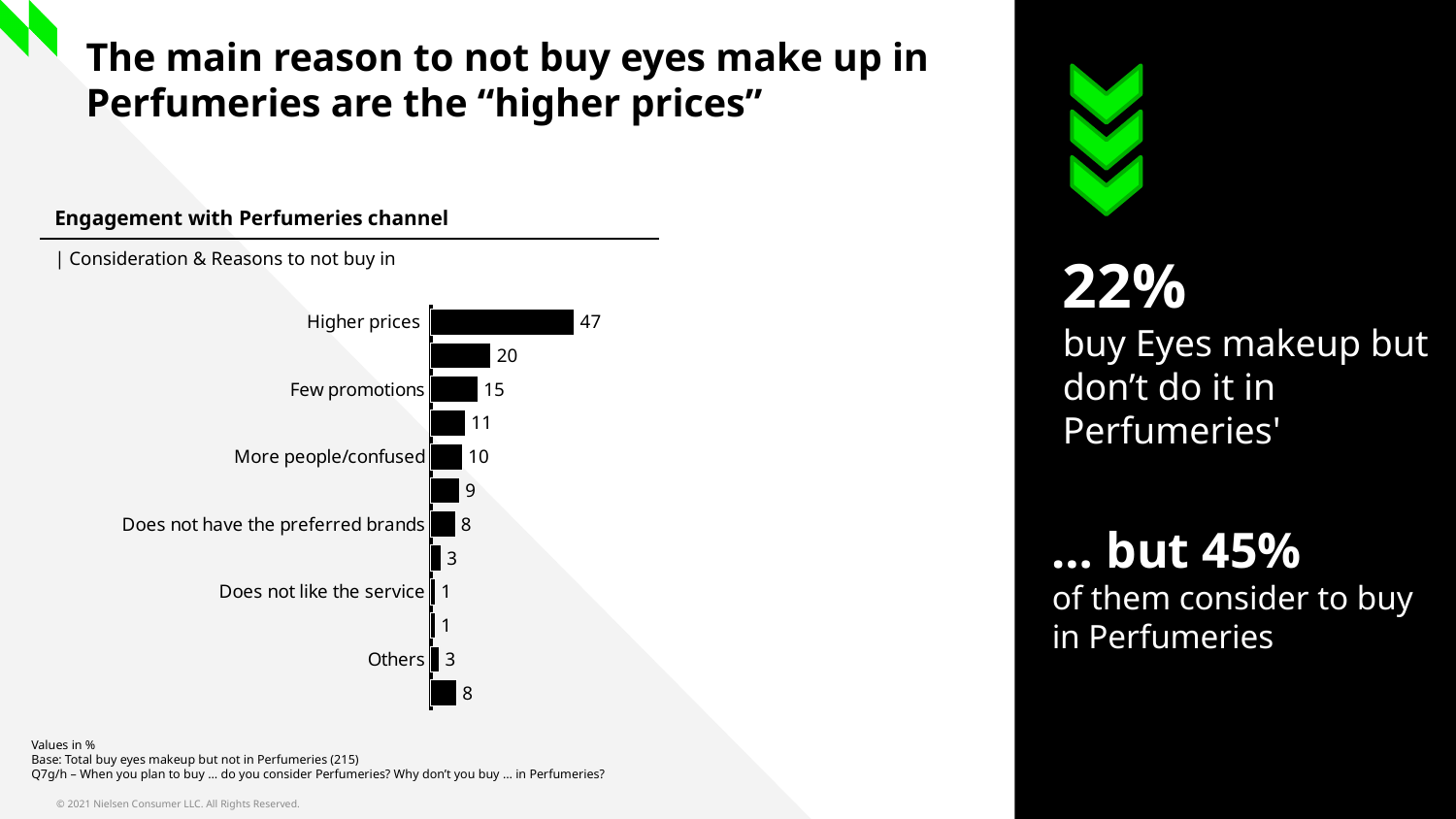
What is the difference between the values for Higher prices and Few promotions? 32 Which is larger, the value for Few promotions or the value for More people/confused? Few promotions What is the value for More people/confused? 10 How many bars are plotted in the chart? 12 What is the value for Few promotions? 15 What kind of chart is shown? Bar chart What is the value for Others? 3 What is the value for Does not have the preferred brands? 8 Which category has the highest value? Higher prices What is the value for Higher prices? 47 What is the value for Does not like the service? 1 What is the title of the chart section? Engagement with Perfumeries channel